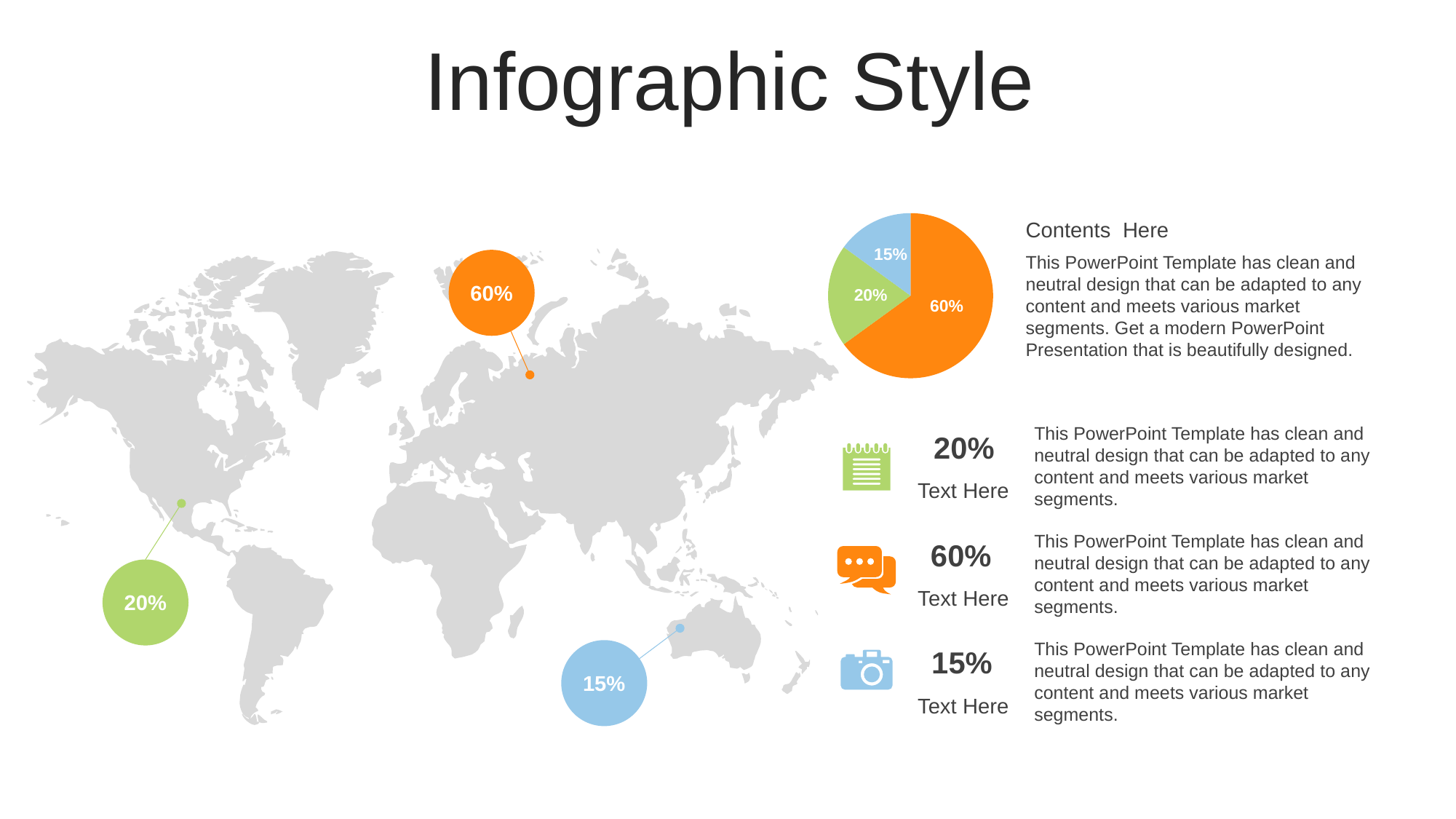
What value is shown on the blue slice of the pie chart? 15% What kind of chart is shown on the slide? pie chart Which slice of the pie chart is larger, the green one or the blue one? green What is the value of the largest slice of the pie chart? 60% What is the value of the smallest slice of the pie chart? 15% What is the difference between the orange slice and the green slice of the pie chart? 40% What share of the pie does the blue slice represent? 15% What is the difference between the green slice and the blue slice of the pie chart? 5% How many slices does the pie chart have? 3 What colour is the largest slice of the pie chart? orange What value is shown on the green slice of the pie chart? 20% What value is shown on the orange slice of the pie chart? 60%